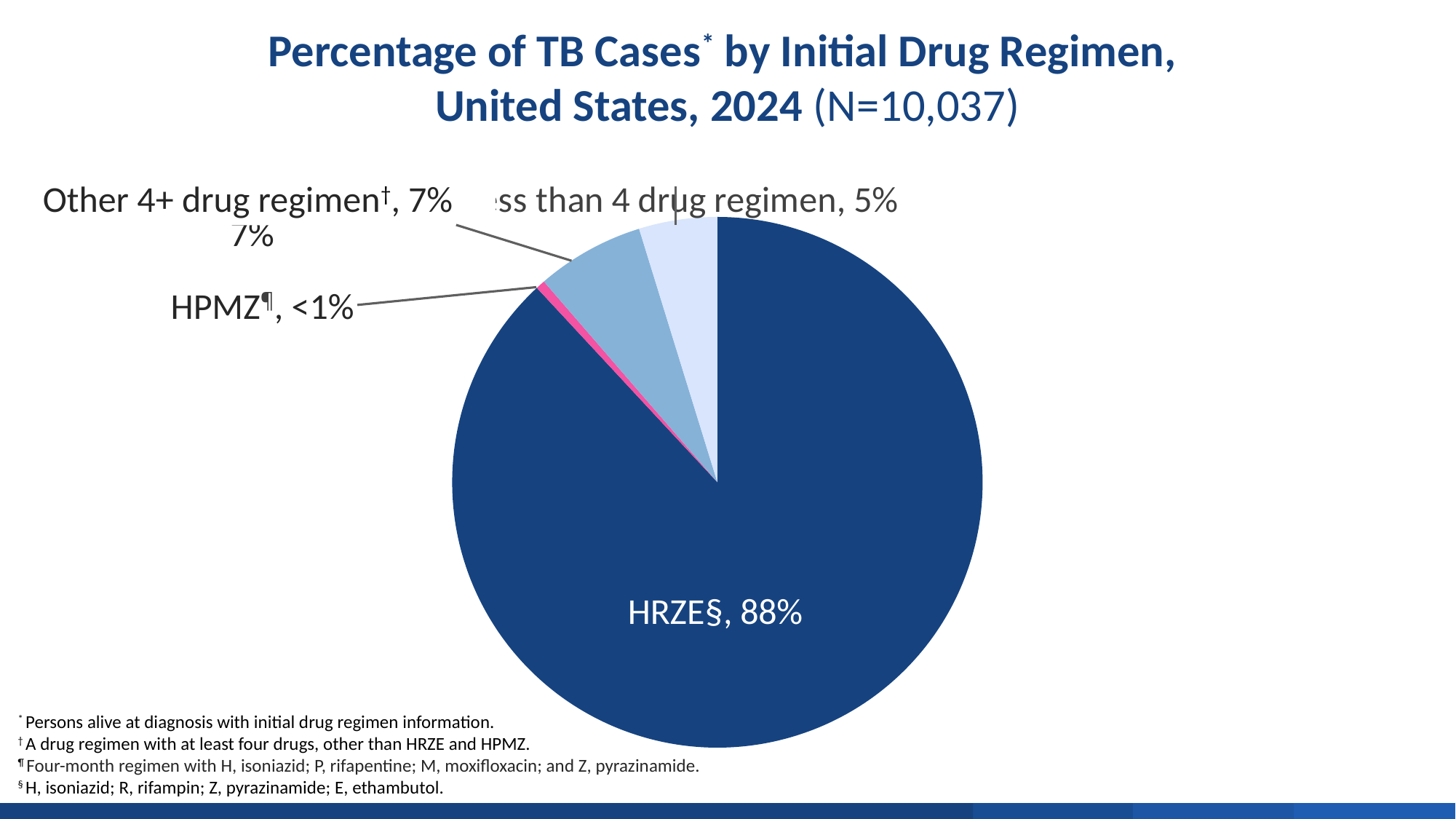
Which initial drug regimen accounts for the largest share of TB cases? HRZE What kind of chart is shown on the slide? pie chart Which is larger: the share for Other 4+ drug regimen or the share for less than 4 drug regimen? Other 4+ drug regimen What is the difference in percentage points between the Other 4+ drug regimen and the less than 4 drug regimen? 2 What percentage of TB cases had HRZE as the initial drug regimen? 88% Which initial drug regimen accounts for the smallest share of TB cases? HPMZ What is the total number of TB cases (N) given in the chart title? 10,037 What percentage of TB cases had HPMZ as the initial drug regimen? <1% What percentage of TB cases had a less than 4 drug regimen? 5% How many slices does the pie chart have? 4 What percentage of TB cases had an Other 4+ drug regimen? 7% What year does the chart title say the data are for? 2024